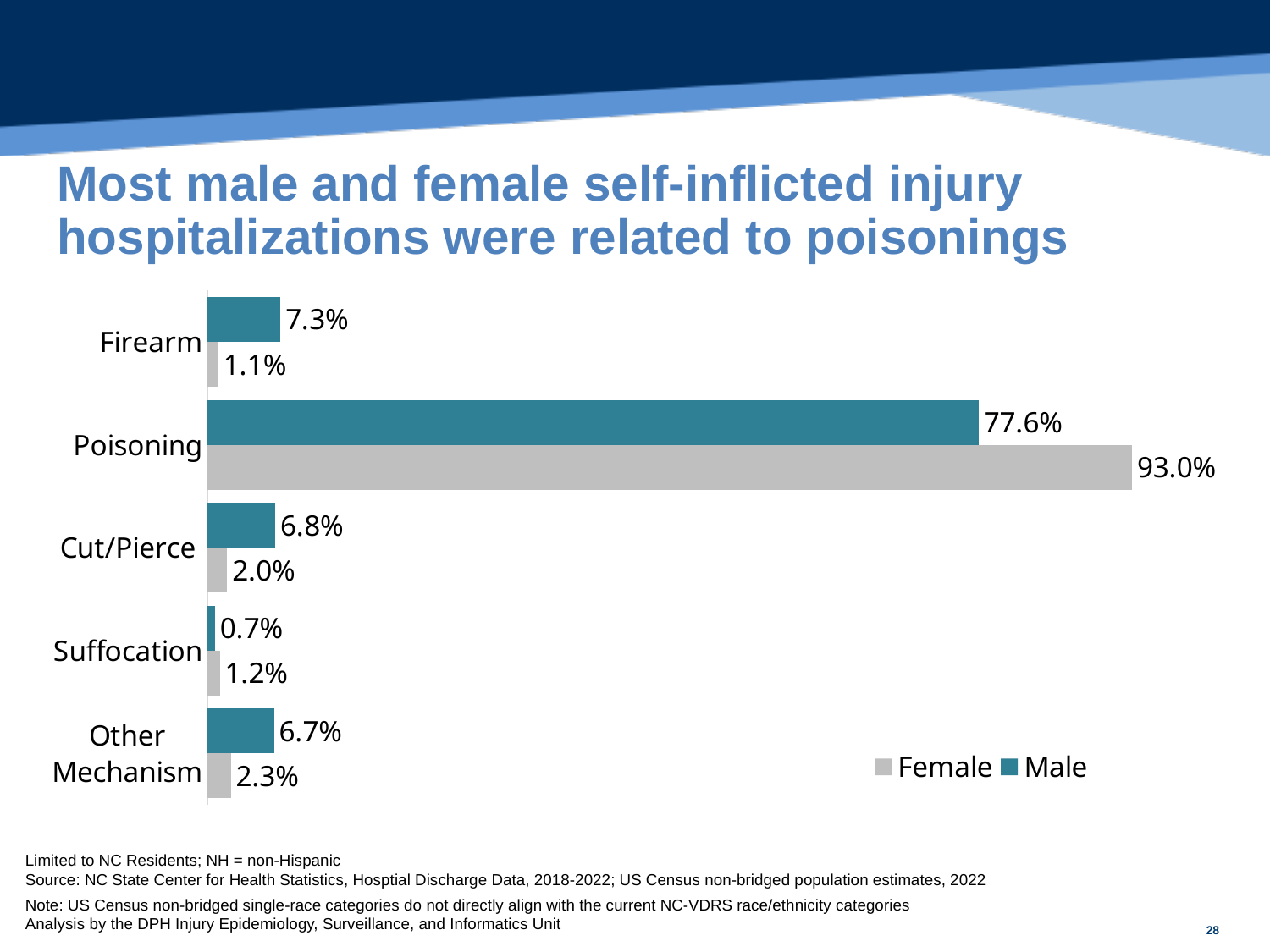
What is the Male value for Firearm? 7.3% What is the Female value for Suffocation? 1.2% What percentage of male self-inflicted injury hospitalizations were related to poisoning? 77.6% Which mechanism has the highest Female percentage? Poisoning Which mechanism has the lowest Male percentage? Suffocation What type of chart is shown on the slide? Bar chart How many series does the legend list? 2 For Cut/Pierce, which is larger, the Male or the Female percentage? Male Which colour represents the Female series in the chart? Gray What is the difference between the Female and Male percentages for Poisoning? 15.4% What percentage of female self-inflicted injury hospitalizations were related to poisoning? 93.0% How many mechanism categories are shown in the chart? 5